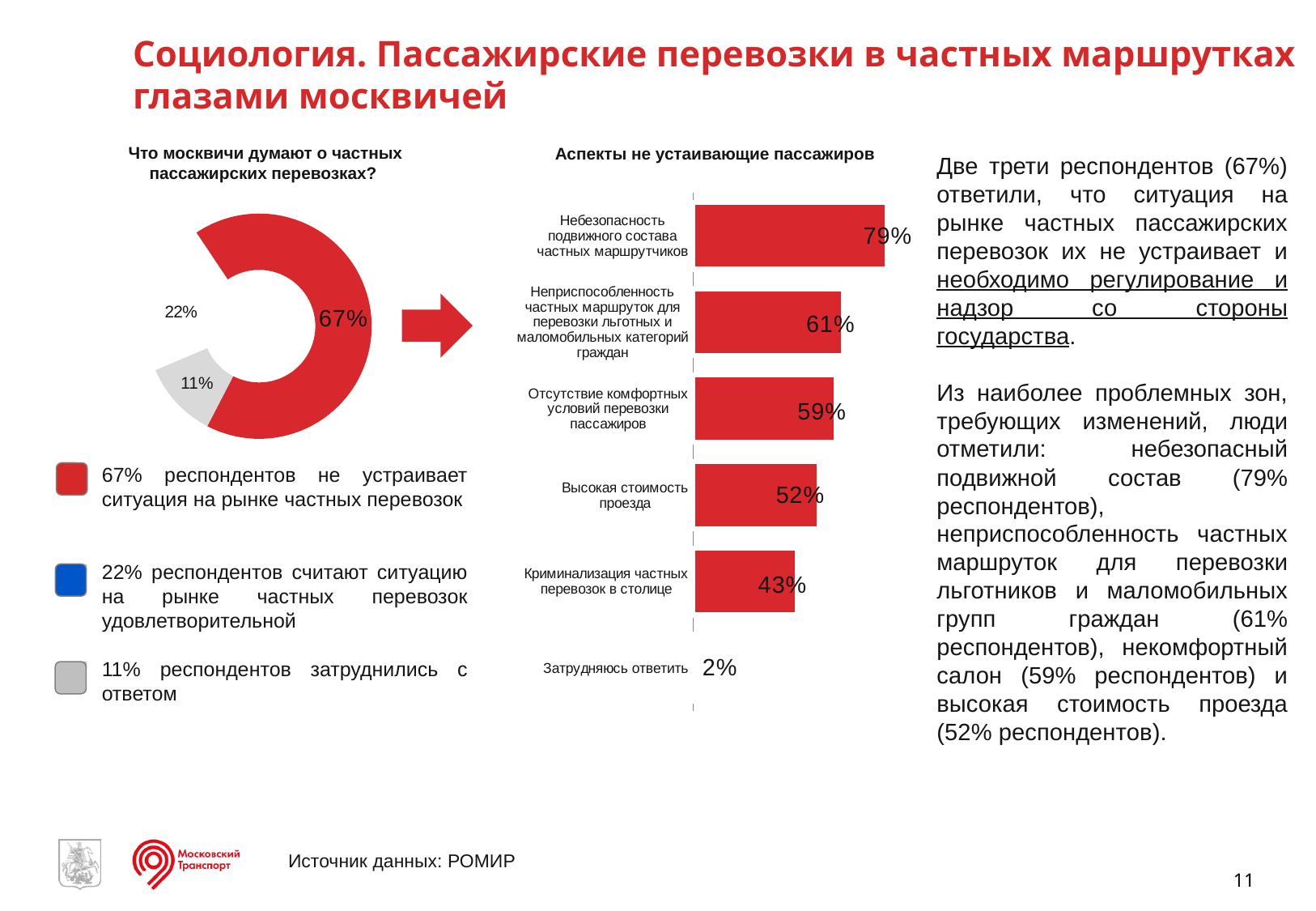
On the bar chart 'Аспекты не устаивающие пассажиров', which is larger: 'Отсутствие комфортных условий перевозки пассажиров' or 'Высокая стоимость проезда'? Отсутствие комфортных условий перевозки пассажиров On the bar chart 'Аспекты не устаивающие пассажиров', what is the difference between the values for 'Небезопасность подвижного состава частных маршрутчиков' and 'Криминализация частных перевозок в столице'? 36% What type of chart is 'Аспекты не устаивающие пассажиров'? Bar chart On the bar chart 'Аспекты не устаивающие пассажиров', what is the value for 'Высокая стоимость проезда'? 52% How many categories are shown on the bar chart 'Аспекты не устаивающие пассажиров'? 6 On the donut chart 'Что москвичи думают о частных пассажирских перевозках?', what share of respondents are not satisfied with the situation on the private transport market? 67% On the bar chart 'Аспекты не устаивающие пассажиров', which category has the lowest value? Затрудняюсь ответить On the bar chart 'Аспекты не устаивающие пассажиров', what is the value for 'Небезопасность подвижного состава частных маршрутчиков'? 79% What type of chart is 'Что москвичи думают о частных пассажирских перевозках?'? Donut chart On the bar chart 'Аспекты не устаивающие пассажиров', what is the value for 'Криминализация частных перевозок в столице'? 43% On the donut chart 'Что москвичи думают о частных пассажирских перевозках?', what is the value for respondents who found it difficult to answer? 11% On the bar chart 'Аспекты не устаивающие пассажиров', which category has the highest value? Небезопасность подвижного состава частных маршрутчиков